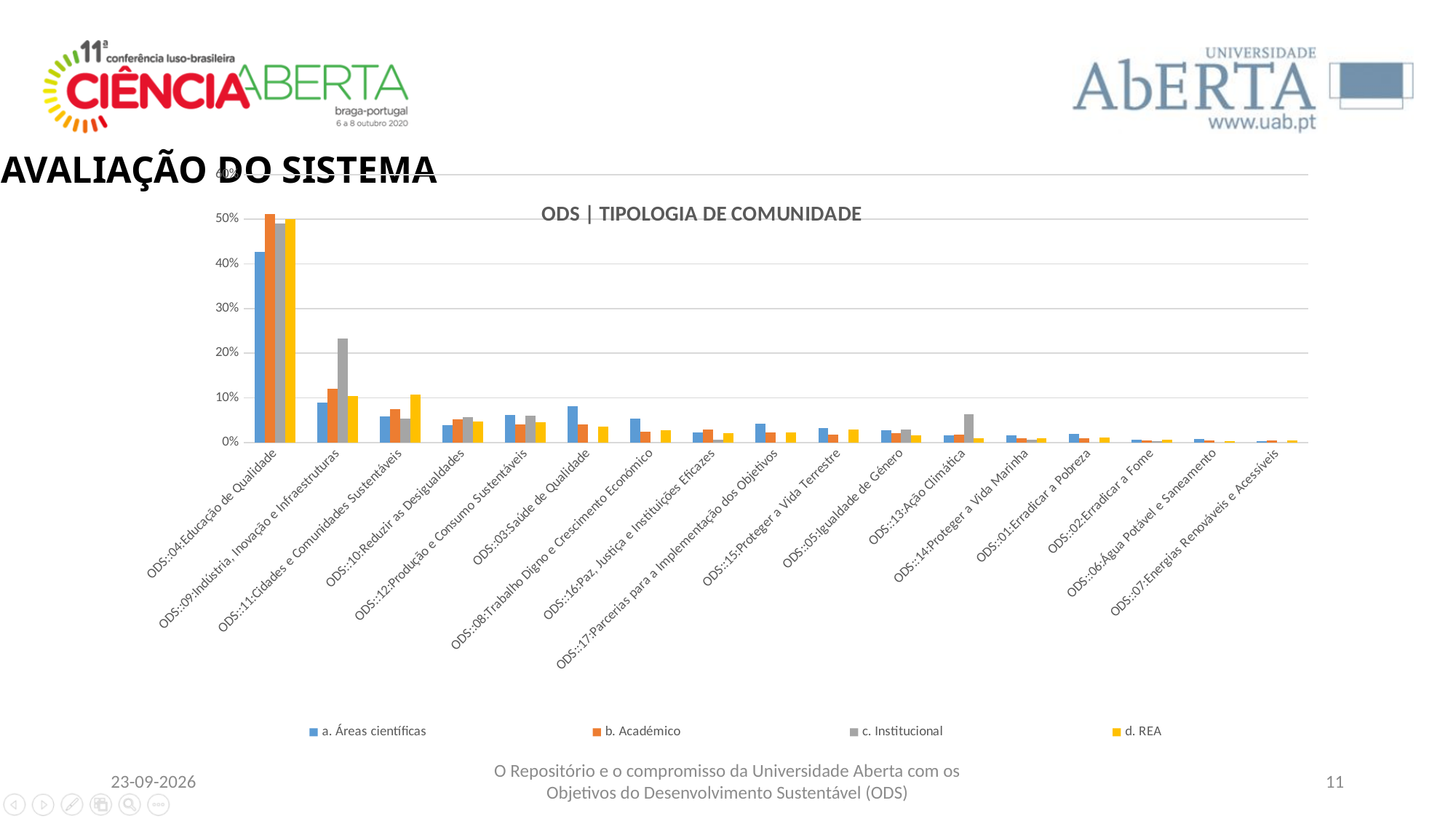
Is the value for c. Institucional in ODS::09:Indústria, Inovação e Infraestruturas greater or less than 20%? greater Which ODS category has the highest values across all series? ODS::04:Educação de Qualidade How many ODS categories are shown along the x axis of the chart? 17 Which series has the larger value in ODS::09:Indústria, Inovação e Infraestruturas: c. Institucional or d. REA? c. Institucional What is the title of the chart? ODS | TIPOLOGIA DE COMUNIDADE How many series does the legend of the chart list? 4 Is the value for a. Áreas científicas in ODS::09:Indústria, Inovação e Infraestruturas greater or less than 10%? less Do the values generally rise or fall moving from left to right along the x axis? fall Is the value for a. Áreas científicas in ODS::04:Educação de Qualidade greater or less than 40%? greater Which series has the larger value in ODS::13:Ação Climática: c. Institucional or a. Áreas científicas? c. Institucional What kind of chart is shown on the slide? bar chart